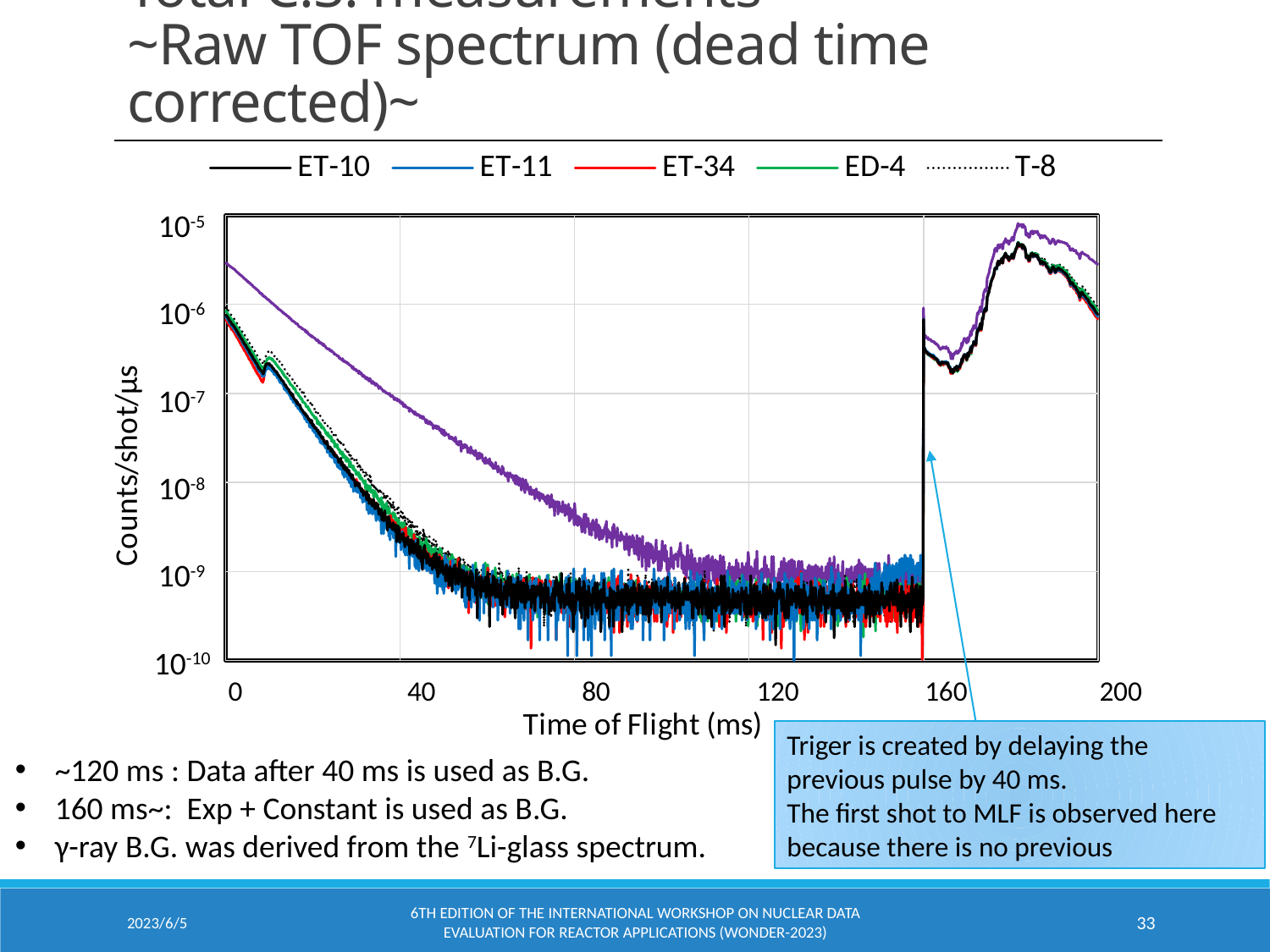
Is the value for ET-11 at a time of flight of 100 ms greater or less than 10^-8? less Is the value for ET-10 at a time of flight of 0 ms greater or less than 10^-7? greater Is the value for ED-4 at a time of flight of 20 ms greater or less than 10^-6? less What is the label of the x axis of the chart? Time of Flight (ms) What kind of chart is shown on the slide? line chart Do the values of the ET-10 series rise or fall along the x axis between 0 ms and 40 ms? fall How many labelled tick marks are shown on the x axis of the chart? 6 What is the lowest value labelled on the y axis of the chart? 10^-10 What is the largest value labelled on the x axis of the chart? 200 How many series does the chart legend list? 5 What is the label of the y axis of the chart? Counts/shot/µs